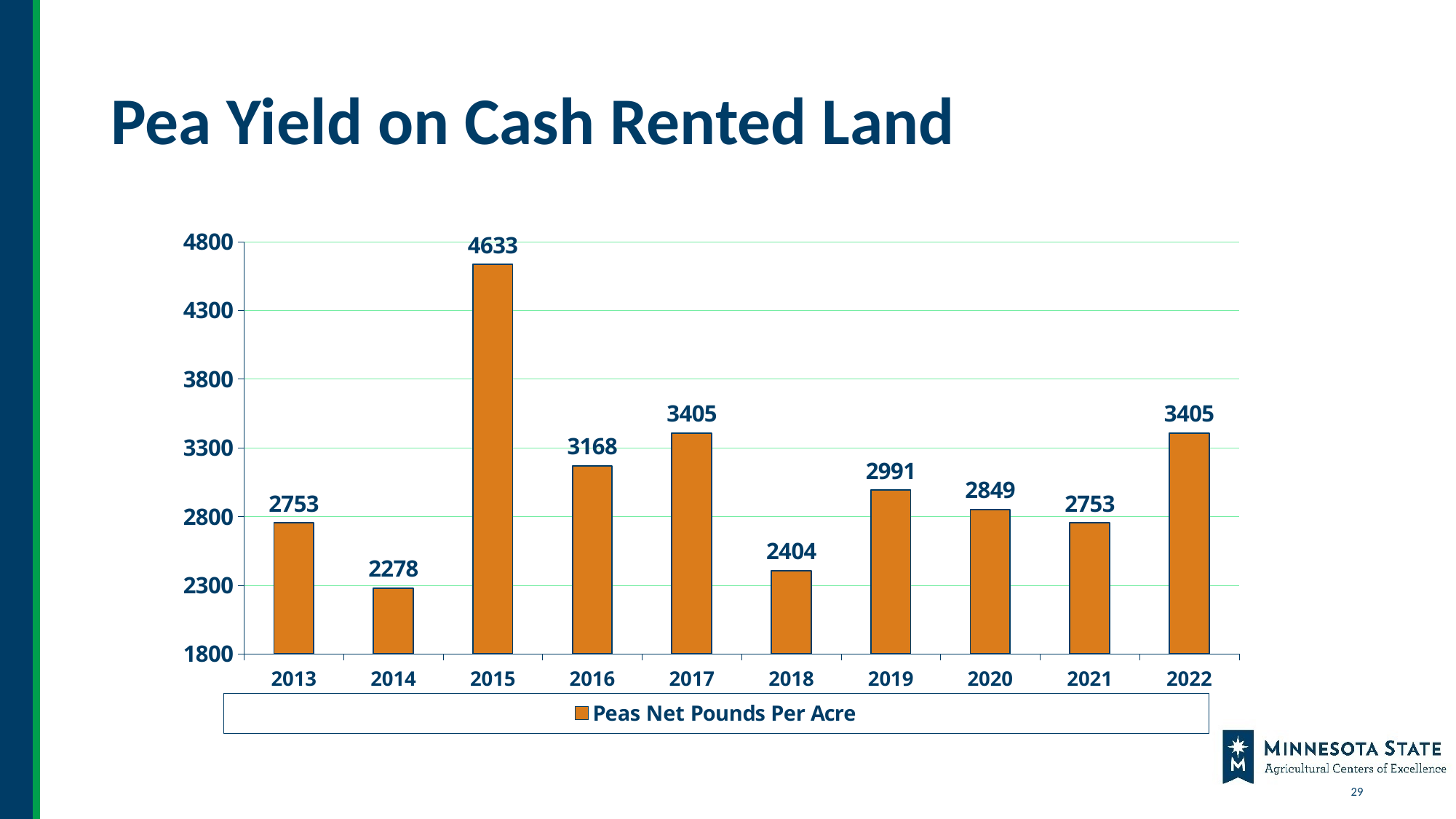
What kind of chart is shown on the slide? bar chart What is the value for 2020? 2849 Which is larger, the value for 2016 or the value for 2019? 2016 How many years are shown on the x axis? 10 Which year has the highest value? 2015 What is the legend entry for the series shown? Peas Net Pounds Per Acre What is the difference between the values for 2015 and 2014? 2355 What is the value for 2018? 2404 What is the difference between the values for 2022 and 2021? 652 Is the value for 2017 greater or less than 3300? greater Which year has the lowest value? 2014 What is the value for 2015? 4633